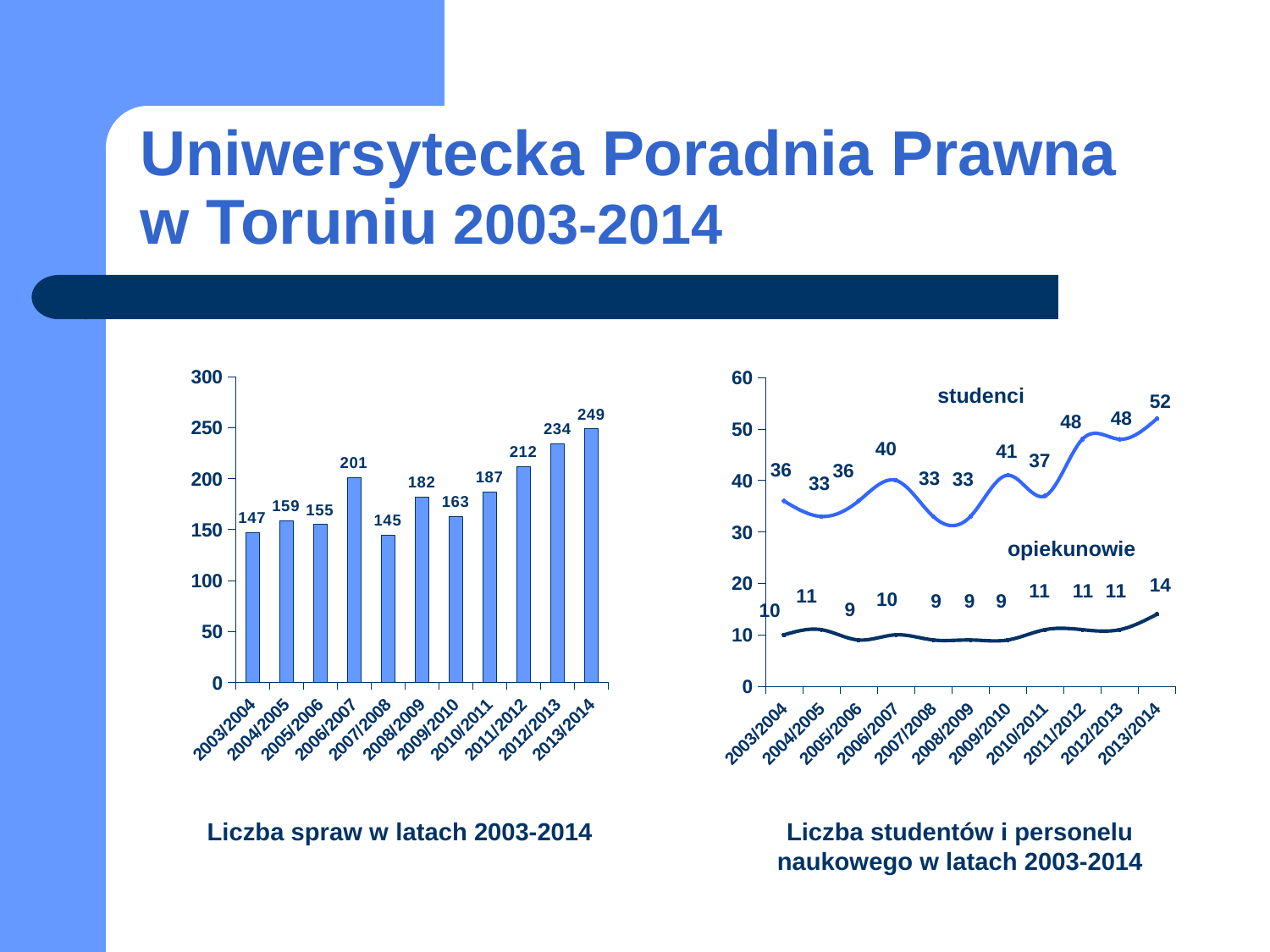
What kind of chart is 'Liczba studentów i personelu naukowego w latach 2003-2014'? line chart What kind of chart is 'Liczba spraw w latach 2003-2014'? bar chart In the chart 'Liczba studentów i personelu naukowego w latach 2003-2014', which is larger for studenci: 2006/2007 or 2010/2011? 2006/2007 In the chart 'Liczba studentów i personelu naukowego w latach 2003-2014', what is the value for opiekunowie in 2004/2005? 11 In the chart 'Liczba spraw w latach 2003-2014', which year has the lowest value? 2007/2008 In the chart 'Liczba spraw w latach 2003-2014', what is the difference between the values for 2013/2014 and 2003/2004? 102 In the chart 'Liczba spraw w latach 2003-2014', what is the value for 2006/2007? 201 In the chart 'Liczba spraw w latach 2003-2014', which year has the highest value? 2013/2014 In the chart 'Liczba studentów i personelu naukowego w latach 2003-2014', what is the difference between studenci and opiekunowie in 2013/2014? 38 In the chart 'Liczba spraw w latach 2003-2014', how many years are shown on the x axis? 11 In the chart 'Liczba studentów i personelu naukowego w latach 2003-2014', what is the value for studenci in 2013/2014? 52 In the chart 'Liczba studentów i personelu naukowego w latach 2003-2014', which year has the highest value for opiekunowie? 2013/2014